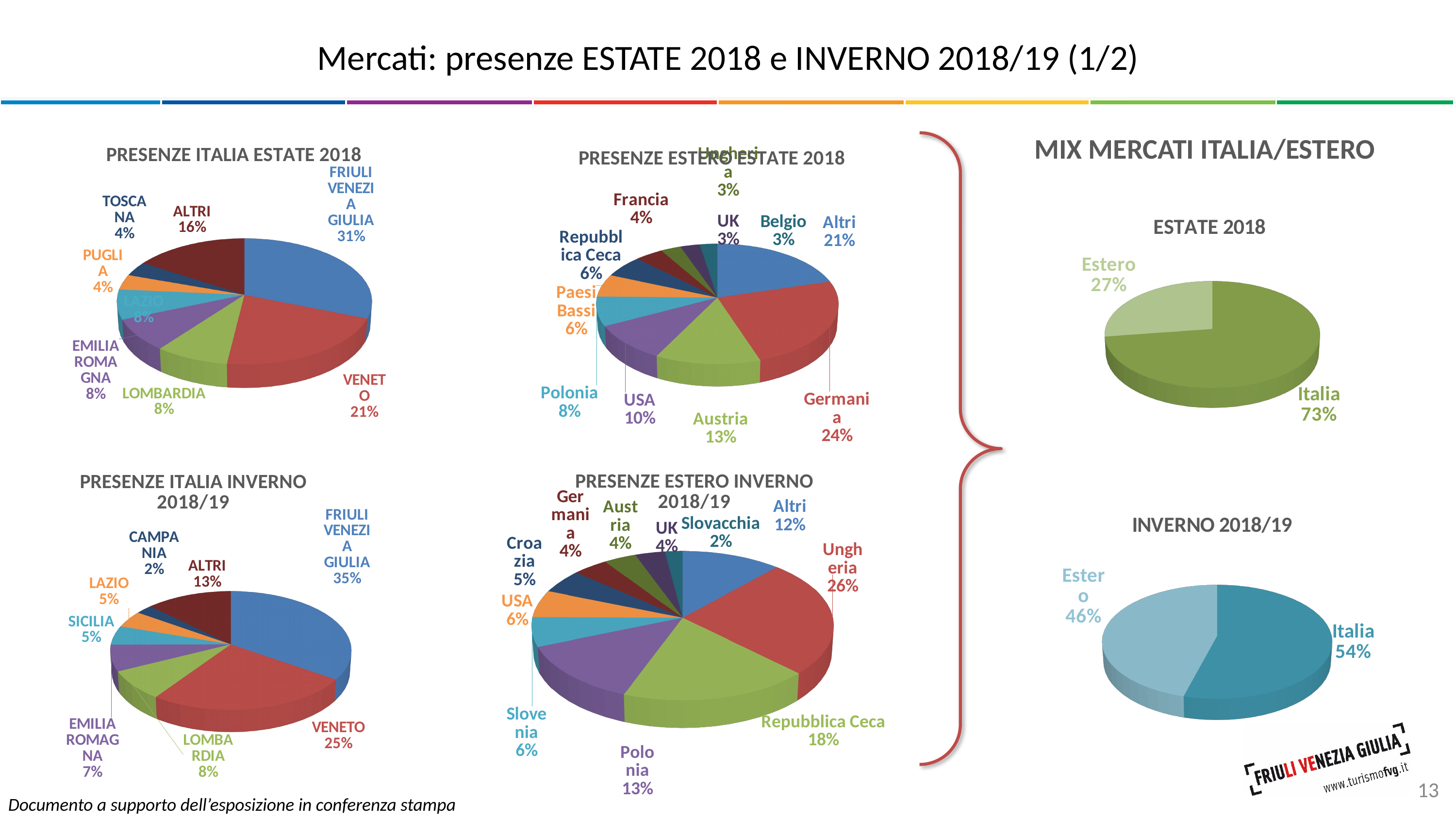
In the PRESENZE ESTERO ESTATE 2018 chart, what is the difference between the shares of Austria and USA? 3% In the PRESENZE ESTERO ESTATE 2018 chart, what share does Germania have? 24% In the PRESENZE ITALIA ESTATE 2018 chart, what share does FRIULI VENEZIA GIULIA have? 31% How many slices does the PRESENZE ESTERO INVERNO 2018/19 pie chart have? 11 In the PRESENZE ESTERO INVERNO 2018/19 chart, which country has the largest share? Ungheria In the ESTATE 2018 chart under MIX MERCATI ITALIA/ESTERO, what share does Italia have? 73% In the INVERNO 2018/19 chart under MIX MERCATI ITALIA/ESTERO, what share does Estero have? 46% In the PRESENZE ITALIA ESTATE 2018 chart, which region (excluding ALTRI) has the largest share? FRIULI VENEZIA GIULIA In the PRESENZE ESTERO INVERNO 2018/19 chart, which is larger: Repubblica Ceca or Polonia? Repubblica Ceca What type of chart is used for PRESENZE ITALIA ESTATE 2018? Pie chart In the PRESENZE ITALIA INVERNO 2018/19 chart, what share does VENETO have? 25% In the PRESENZE ITALIA INVERNO 2018/19 chart, which region has the smallest share? CAMPANIA